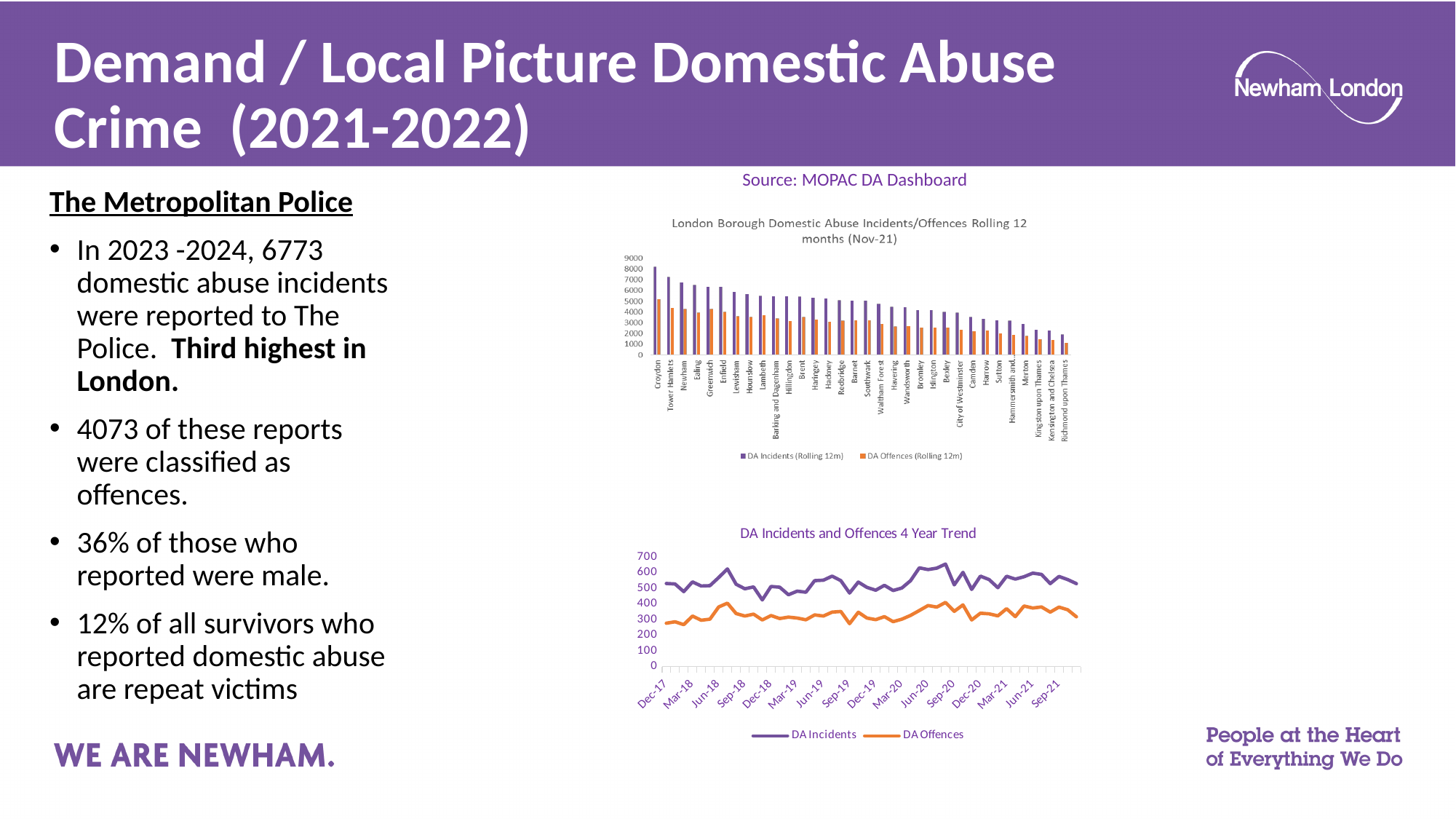
In the top bar chart, is the DA Incidents (Rolling 12m) value for Richmond upon Thames greater or less than 2000? less What type of chart is the bottom chart titled 'DA Incidents and Offences 4 Year Trend'? line chart In the top bar chart, how many boroughs are shown on the x axis? 32 In the top bar chart, which borough has the lowest number of DA Incidents (Rolling 12m)? Richmond upon Thames In the top bar chart, which borough has the highest number of DA Incidents (Rolling 12m)? Croydon In the top bar chart, is the DA Incidents (Rolling 12m) value for Croydon greater or less than 7000? greater What type of chart is the top chart titled 'London Borough Domestic Abuse Incidents/Offences Rolling 12 months (Nov-21)'? bar chart How many series does the legend of the top bar chart list? 2 In the top bar chart, which is larger for Newham: DA Incidents (Rolling 12m) or DA Offences (Rolling 12m)? DA Incidents (Rolling 12m) In the bottom line chart, is the DA Offences value at Dec-17 greater or less than 400? less In the bottom line chart, which series is consistently higher across the whole period: DA Incidents or DA Offences? DA Incidents